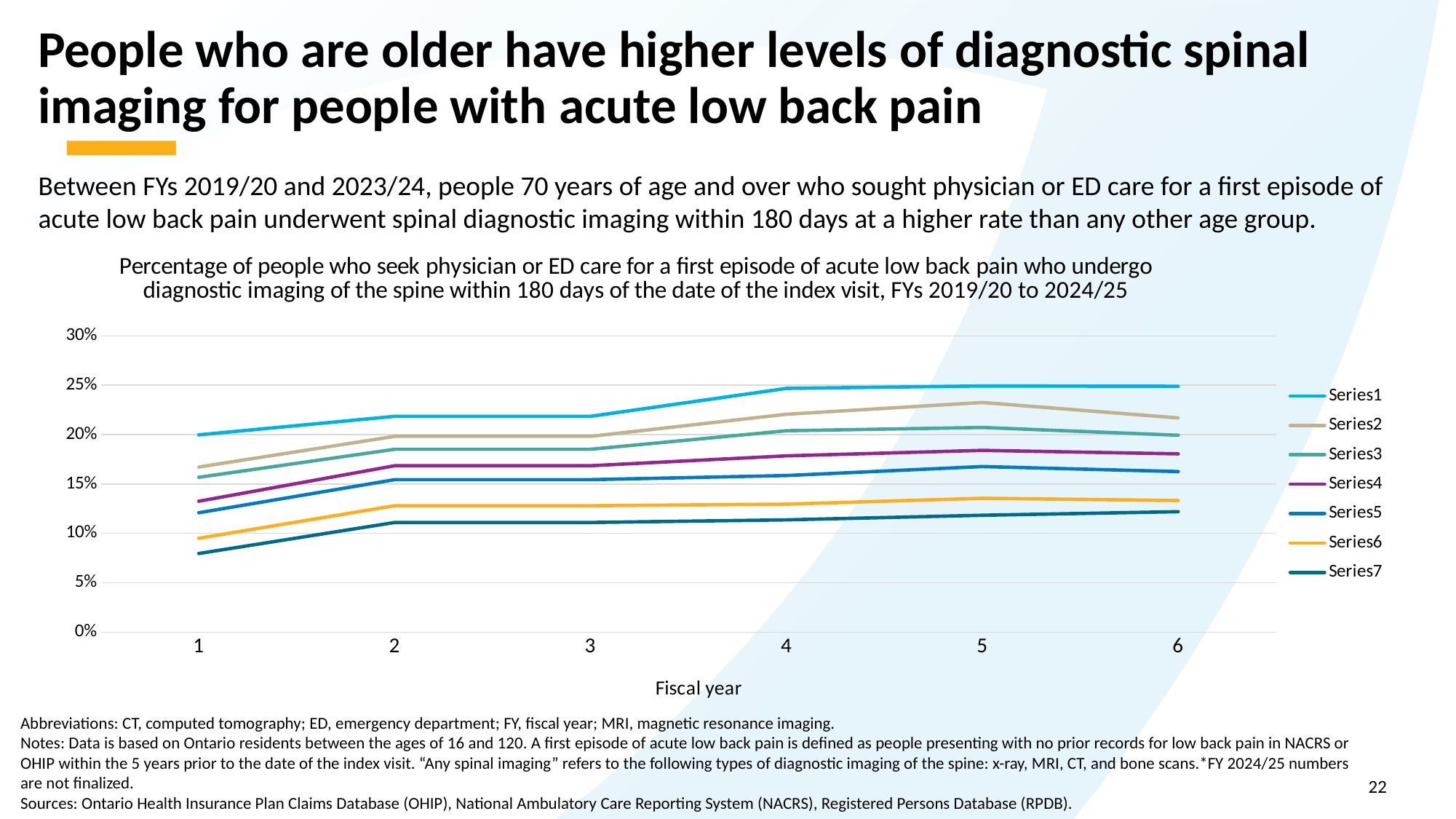
At fiscal year 6, which is larger: Series3 or Series4? Series3 Does the value for Series1 rise or fall from fiscal year 1 to fiscal year 4? rise Which series has the highest value at fiscal year 6? Series1 How many series does the legend list? 7 Is the value for Series6 at fiscal year 3 greater or less than 15%? less What kind of chart is shown on the slide? line chart Which series has the lowest value at fiscal year 1? Series7 Is the value for Series7 at fiscal year 1 greater or less than 10%? less Is the value for Series2 at fiscal year 5 greater or less than 20%? greater How many fiscal year points are plotted along the x axis? 6 What is the title of the x axis? Fiscal year